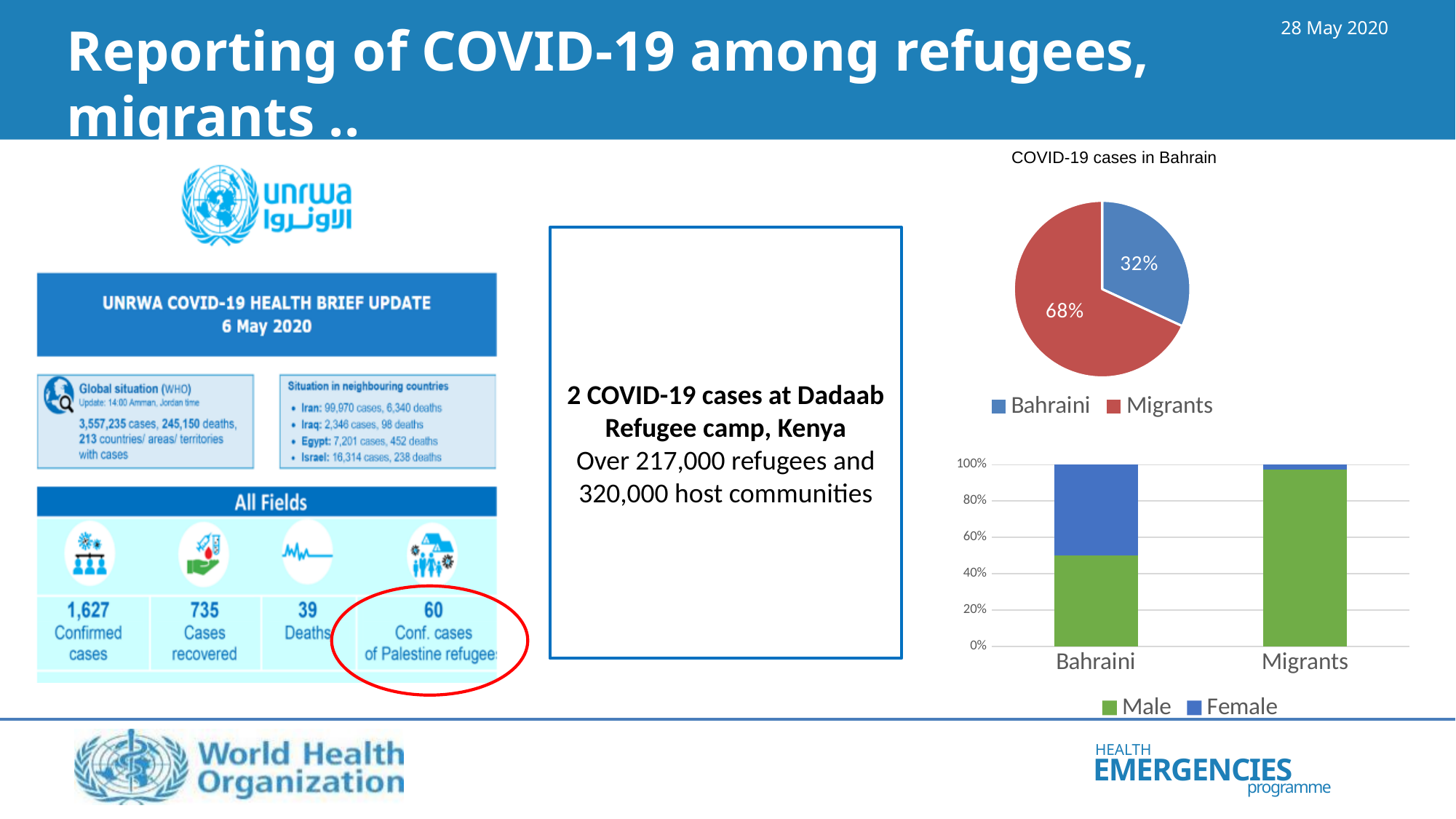
What kind of chart is the chart at the bottom right of the slide showing Bahraini and Migrants by Male and Female? Stacked bar chart In the pie chart titled 'COVID-19 cases in Bahrain', which group has the smaller share? Bahraini How many slices does the pie chart titled 'COVID-19 cases in Bahrain' have? 2 In the bottom-right bar chart, is the Female share for Migrants greater or less than 20%? less How many series does the legend of the bottom-right bar chart list? 2 In the pie chart titled 'COVID-19 cases in Bahrain', what share of cases is Bahraini? 32% In the pie chart titled 'COVID-19 cases in Bahrain', what share of cases is Migrants? 68% What kind of chart is the chart titled 'COVID-19 cases in Bahrain'? Pie chart In the bottom-right bar chart, which category has the larger Female share, Bahraini or Migrants? Bahraini In the pie chart titled 'COVID-19 cases in Bahrain', which group has the larger share? Migrants In the bottom-right bar chart, is the Male share for Migrants greater or less than 80%? greater In the pie chart titled 'COVID-19 cases in Bahrain', what is the difference in percentage points between the Migrants share and the Bahraini share? 36